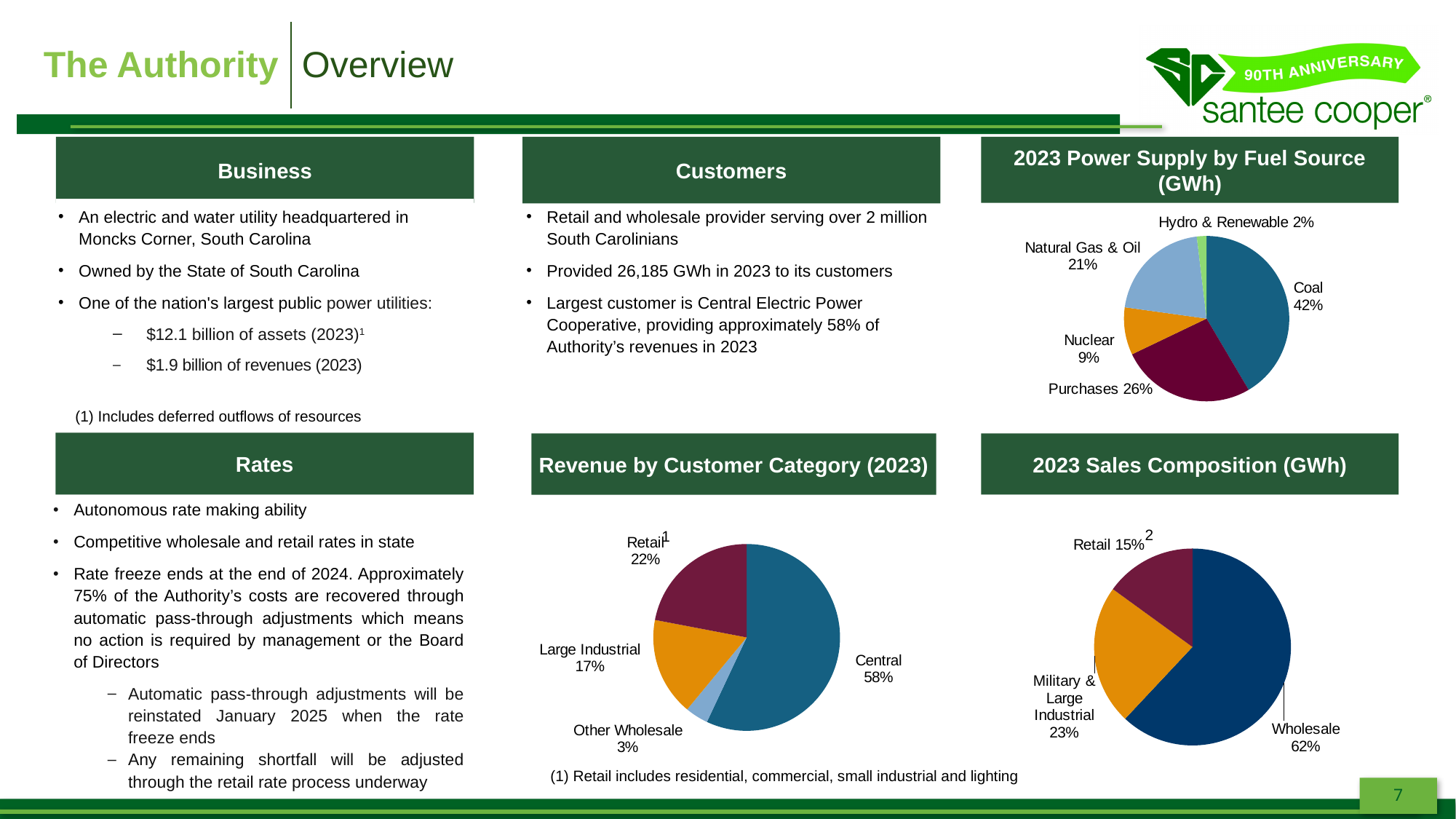
In the '2023 Power Supply by Fuel Source (GWh)' chart, what share does Coal have? 42% In the '2023 Power Supply by Fuel Source (GWh)' chart, which is larger, Nuclear or Natural Gas & Oil? Natural Gas & Oil In the 'Revenue by Customer Category (2023)' chart, what is the share for Other Wholesale? 3% In the '2023 Power Supply by Fuel Source (GWh)' chart, how many fuel source categories are shown? 5 In the '2023 Power Supply by Fuel Source (GWh)' chart, what is the difference between the Purchases share and the Natural Gas & Oil share? 5% In the 'Revenue by Customer Category (2023)' chart, what is the difference between the Retail share and the Large Industrial share? 5% In the '2023 Sales Composition (GWh)' chart, which category has the smallest share? Retail What type of chart is the '2023 Sales Composition (GWh)' chart? Pie chart In the '2023 Power Supply by Fuel Source (GWh)' chart, which fuel source has the smallest share? Hydro & Renewable In the 'Revenue by Customer Category (2023)' chart, what share does Central have? 58% In the '2023 Sales Composition (GWh)' chart, what share does Wholesale have? 62% In the 'Revenue by Customer Category (2023)' chart, which category has the largest share? Central